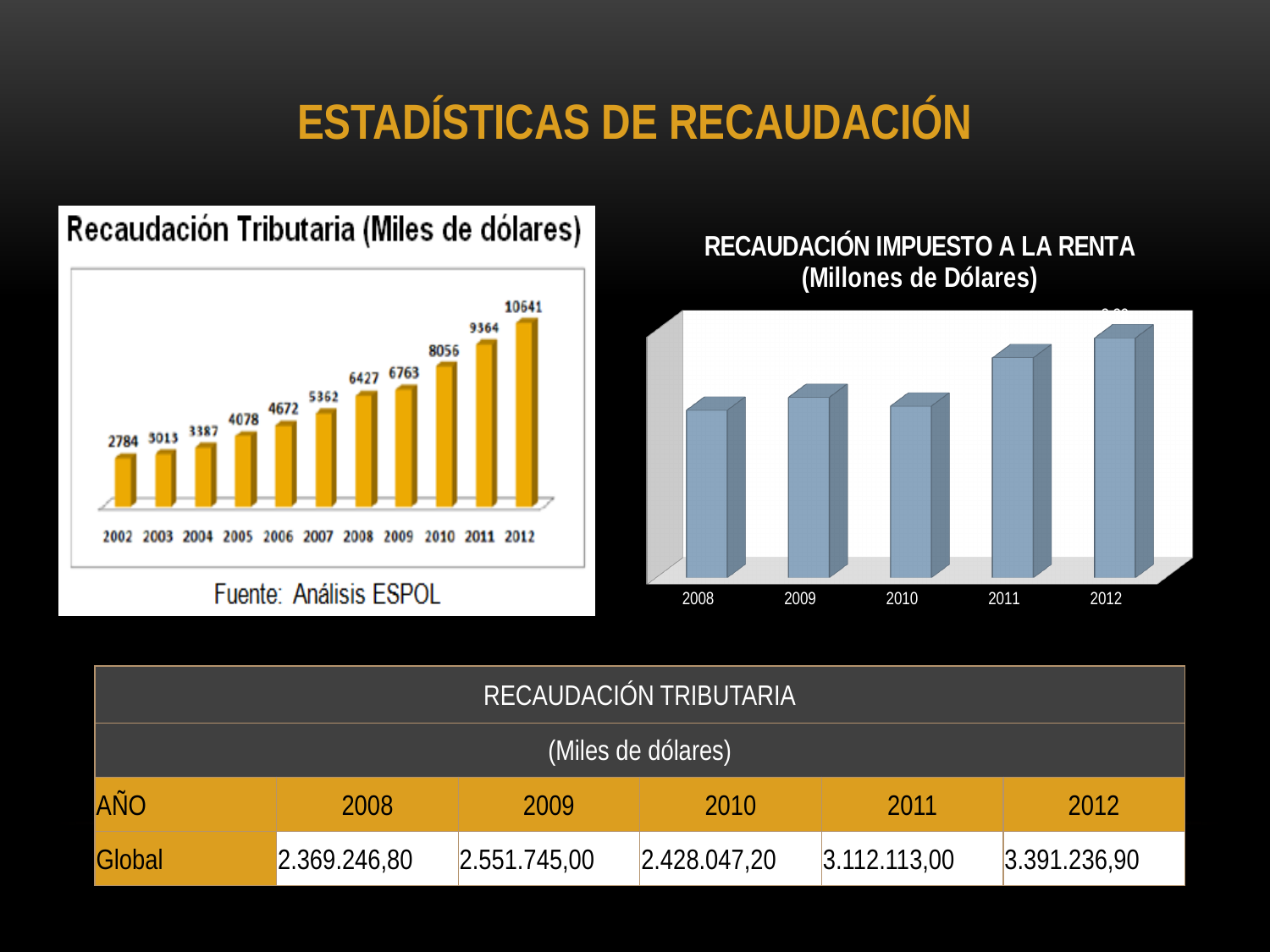
In the chart titled 'Recaudación Tributaria (Miles de dólares)', which year has the lowest value? 2002 In the chart titled 'RECAUDACIÓN IMPUESTO A LA RENTA (Millones de Dólares)', how many years are shown on the x axis? 5 In the chart titled 'Recaudación Tributaria (Miles de dólares)', what is the difference between the values for 2012 and 2011? 1277 In the chart titled 'RECAUDACIÓN IMPUESTO A LA RENTA (Millones de Dólares)', which bar is taller, 2011 or 2009? 2011 In the chart titled 'Recaudación Tributaria (Miles de dólares)', what is the value for 2002? 2784 In the chart titled 'Recaudación Tributaria (Miles de dólares)', how many years are shown on the x axis? 11 In the chart titled 'Recaudación Tributaria (Miles de dólares)', which year has the highest value? 2012 In the chart titled 'Recaudación Tributaria (Miles de dólares)', what is the value for 2012? 10641 What kind of chart is the one titled 'Recaudación Tributaria (Miles de dólares)'? bar chart In the chart titled 'Recaudación Tributaria (Miles de dólares)', what is the value for 2008? 6427 In the chart titled 'RECAUDACIÓN IMPUESTO A LA RENTA (Millones de Dólares)', which year has the highest bar? 2012 In the chart titled 'Recaudación Tributaria (Miles de dólares)', do the values rise or fall from 2002 to 2012? rise